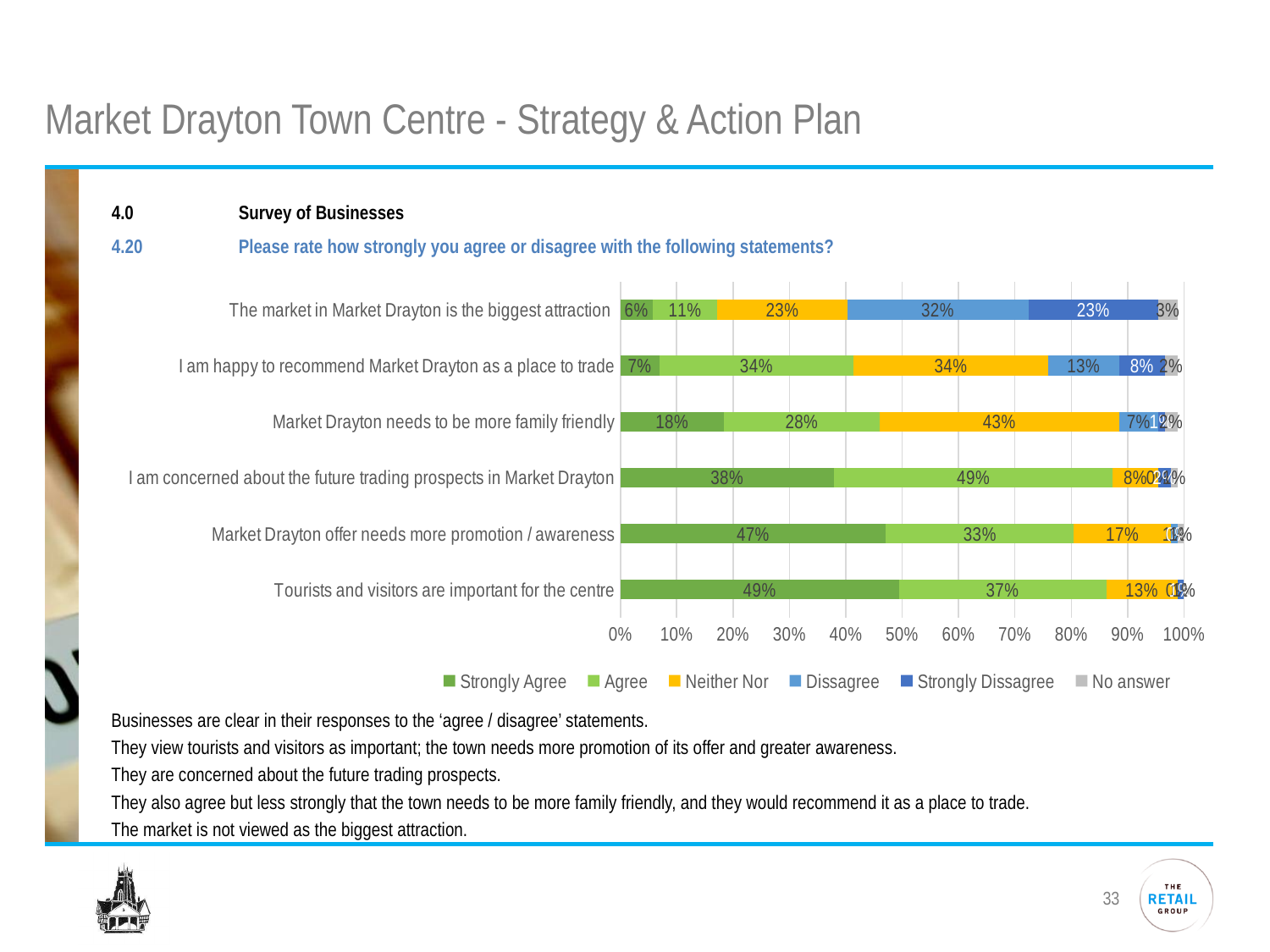
How many response categories does the legend list? 6 What percentage of businesses agree that they are concerned about the future trading prospects in Market Drayton? 49% What percentage of businesses disagree that the market in Market Drayton is the biggest attraction? 32% Which statement has the lowest 'Strongly Agree' percentage? The market in Market Drayton is the biggest attraction What percentage of businesses strongly agree that tourists and visitors are important for the centre? 49% What percentage of businesses answered 'Neither Nor' for 'Market Drayton needs to be more family friendly'? 43% Which is larger: the 'Agree' percentage for 'I am happy to recommend Market Drayton as a place to trade' or the 'Agree' percentage for 'The market in Market Drayton is the biggest attraction'? I am happy to recommend Market Drayton as a place to trade How many statements are shown in the chart? 6 What is the difference between the 'Strongly Agree' percentages for 'Tourists and visitors are important for the centre' and 'The market in Market Drayton is the biggest attraction'? 43% Which statement has the highest 'Strongly Agree' percentage? Tourists and visitors are important for the centre What type of chart is shown on the slide? Stacked bar chart What percentage of businesses strongly agree that the Market Drayton offer needs more promotion / awareness? 47%